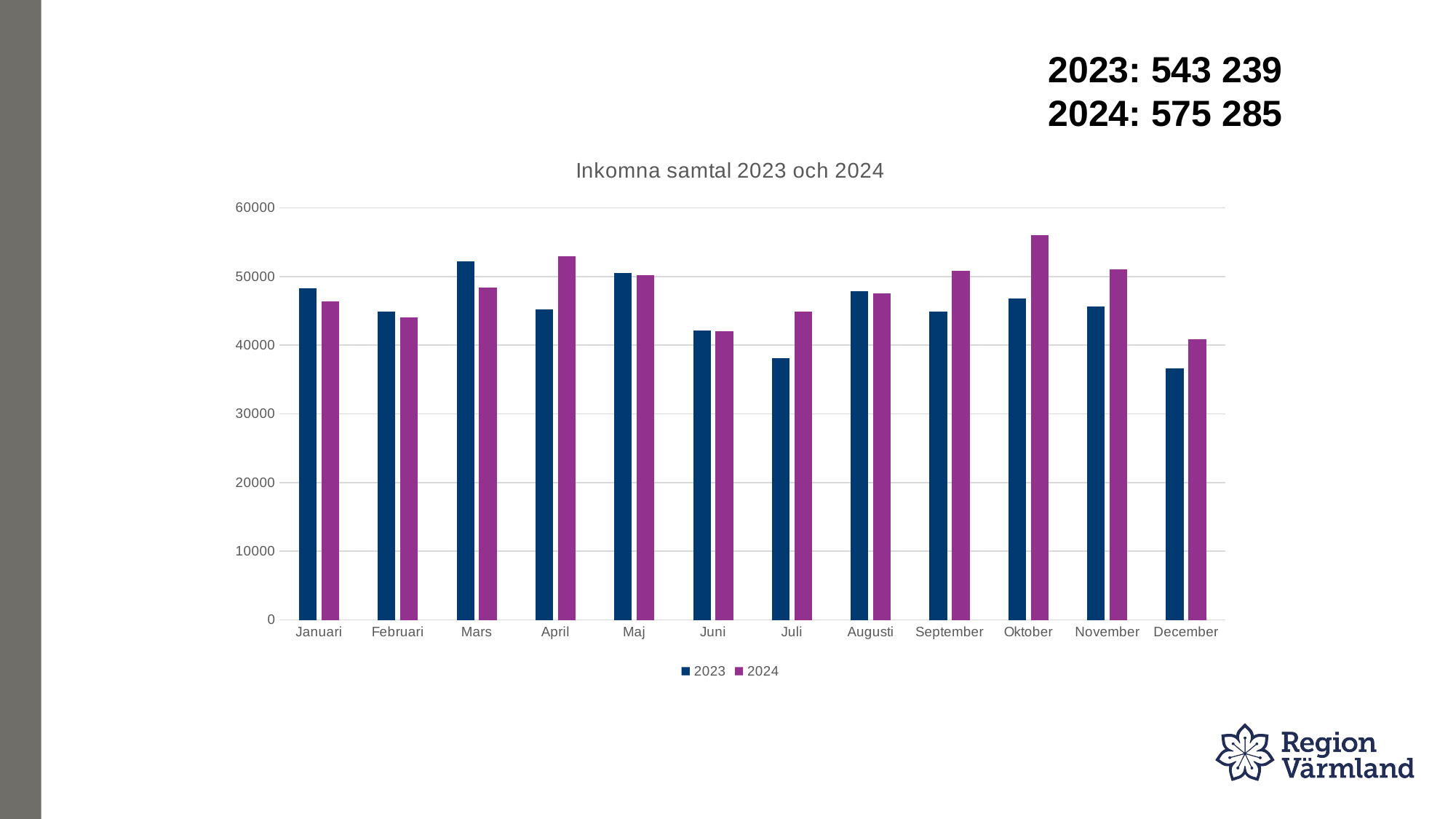
What kind of chart is shown on the slide? bar chart In which month is the 2024 value highest? Oktober For Juli, which series has the larger value, 2023 or 2024? 2024 For Mars, which series has the larger value, 2023 or 2024? 2023 Is the 2024 value for Oktober greater or less than 50000? greater In which month is the 2023 value highest? Mars What is the title of the chart? Inkomna samtal 2023 och 2024 In which month is the 2023 value lowest? December In which month is the 2024 value lowest? December Is the 2023 value for Juli greater or less than 40000? less How many months are shown on the x axis? 12 How many series does the legend list? 2